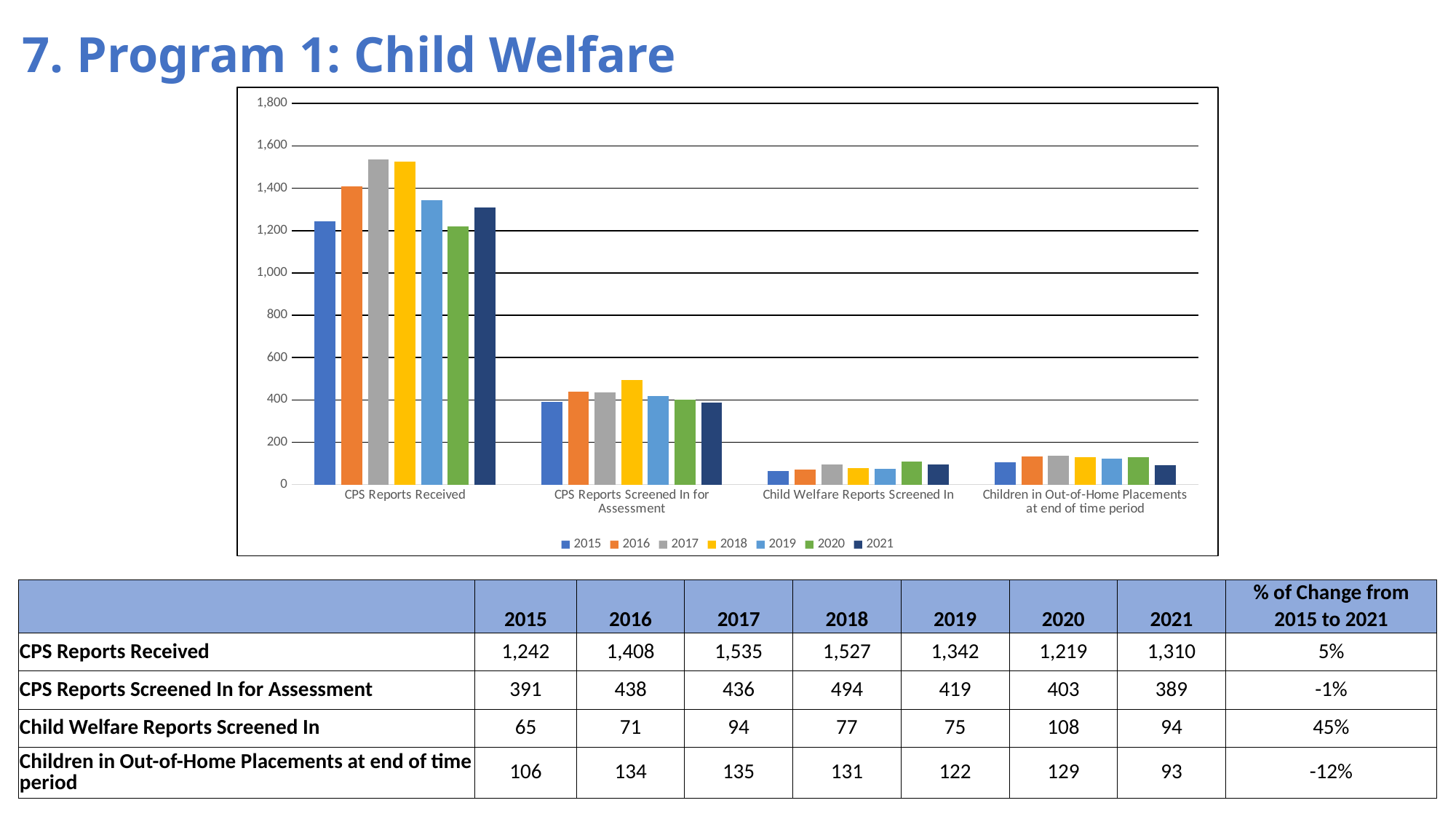
What is the value for Children in Out-of-Home Placements at end of time period in 2021? 93 What is the difference between CPS Reports Received in 2017 and in 2015? 293 What is the value for CPS Reports Received in 2017? 1,535 Which colour represents the 2018 series in the chart legend? Yellow Which year has the lowest value for CPS Reports Received? 2020 Is the value for CPS Reports Received in 2016 greater or less than 1,200? greater Is the value for CPS Reports Screened In for Assessment in 2021 greater or less than 400? less What kind of chart is shown on the slide? Bar chart How many series does the chart legend list? 7 How many categories are shown along the x axis of the chart? 4 Which is larger: Child Welfare Reports Screened In in 2020 or in 2015? 2020 Which year has the highest value for CPS Reports Screened In for Assessment? 2018